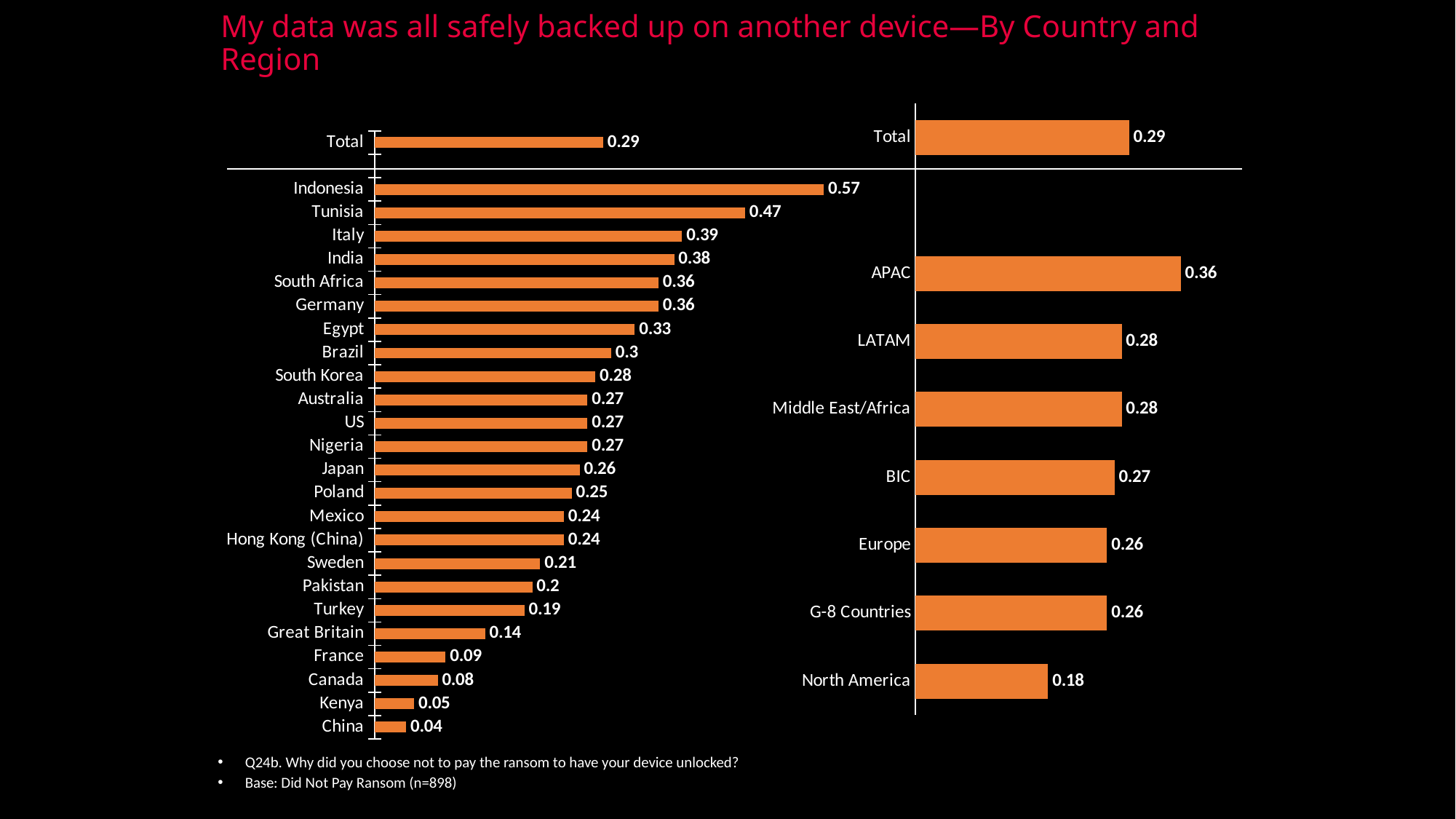
In the right chart (by region), what is the difference between the values for APAC and North America? 0.18 In the right chart (by region), how many regions are shown below the Total bar? 7 In the right chart (by region), which has the larger value, LATAM or Europe? LATAM In the right chart (by region), which region has the highest value? APAC In the left chart (by country), what is the value for Indonesia? 0.57 What is the value of the Total bar shown in both charts? 0.29 In the left chart (by country), what is the difference between the values for Indonesia and Tunisia? 0.1 In the right chart (by region), what is the value for North America? 0.18 In the left chart (by country), which has the larger value, Egypt or Brazil? Egypt In the left chart (by country), what is the value for Great Britain? 0.14 In the left chart (by country), which country has the lowest value? China What kind of chart is used on the left side of the slide? Bar chart